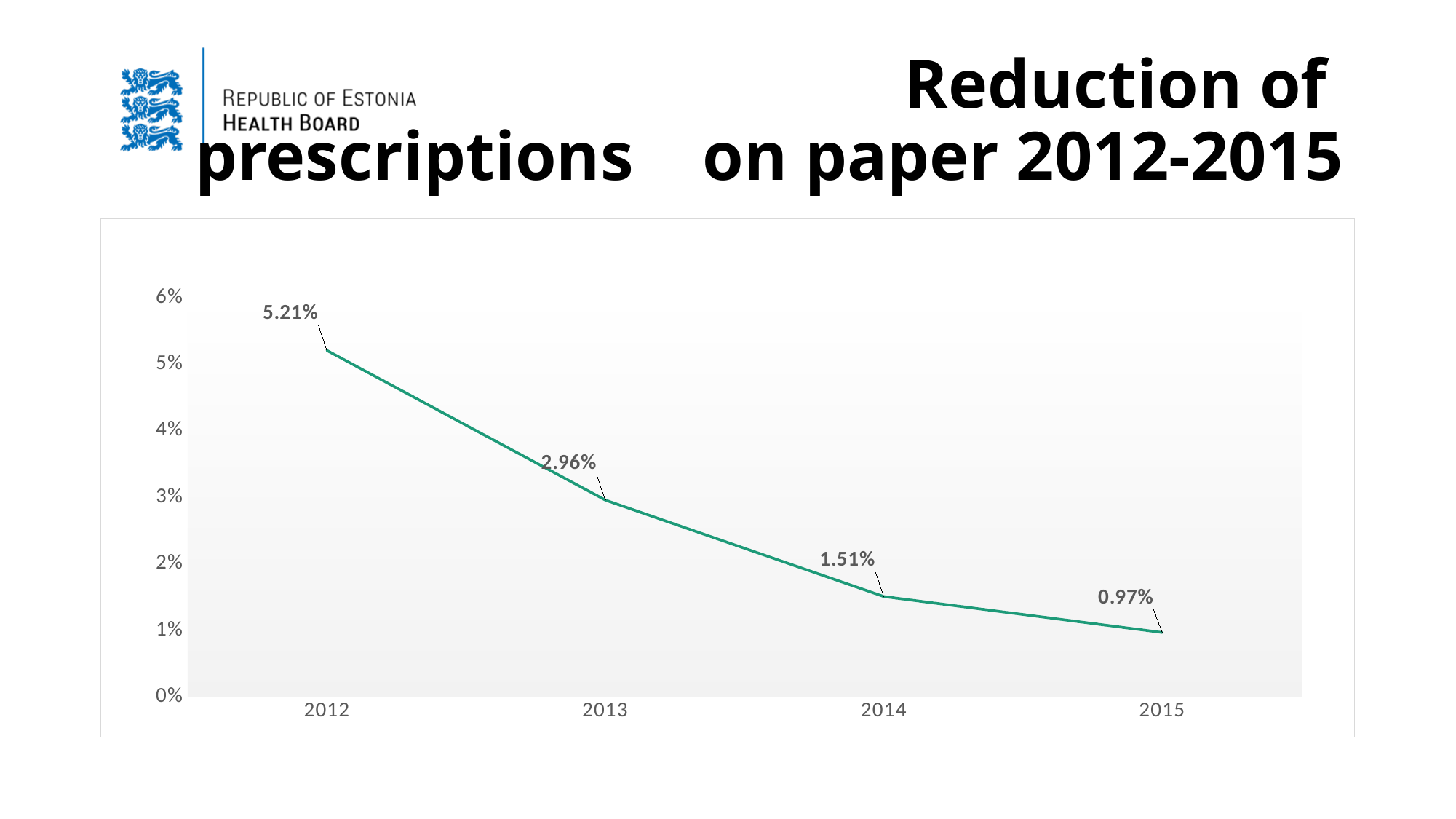
What is the value for 2015? 0.97% What kind of chart is shown on the slide? line chart Which is larger, the value for 2013 or the value for 2014? 2013 Which year has the highest value? 2012 What is the value for 2014? 1.51% Is the value for 2015 greater or less than 1%? less What is the value for 2013? 2.96% What is the difference between the values for 2014 and 2015? 0.54% What is the difference between the values for 2012 and 2013? 2.25% What is the value for 2012? 5.21% How many years are plotted on the chart? 4 Which year has the lowest value? 2015